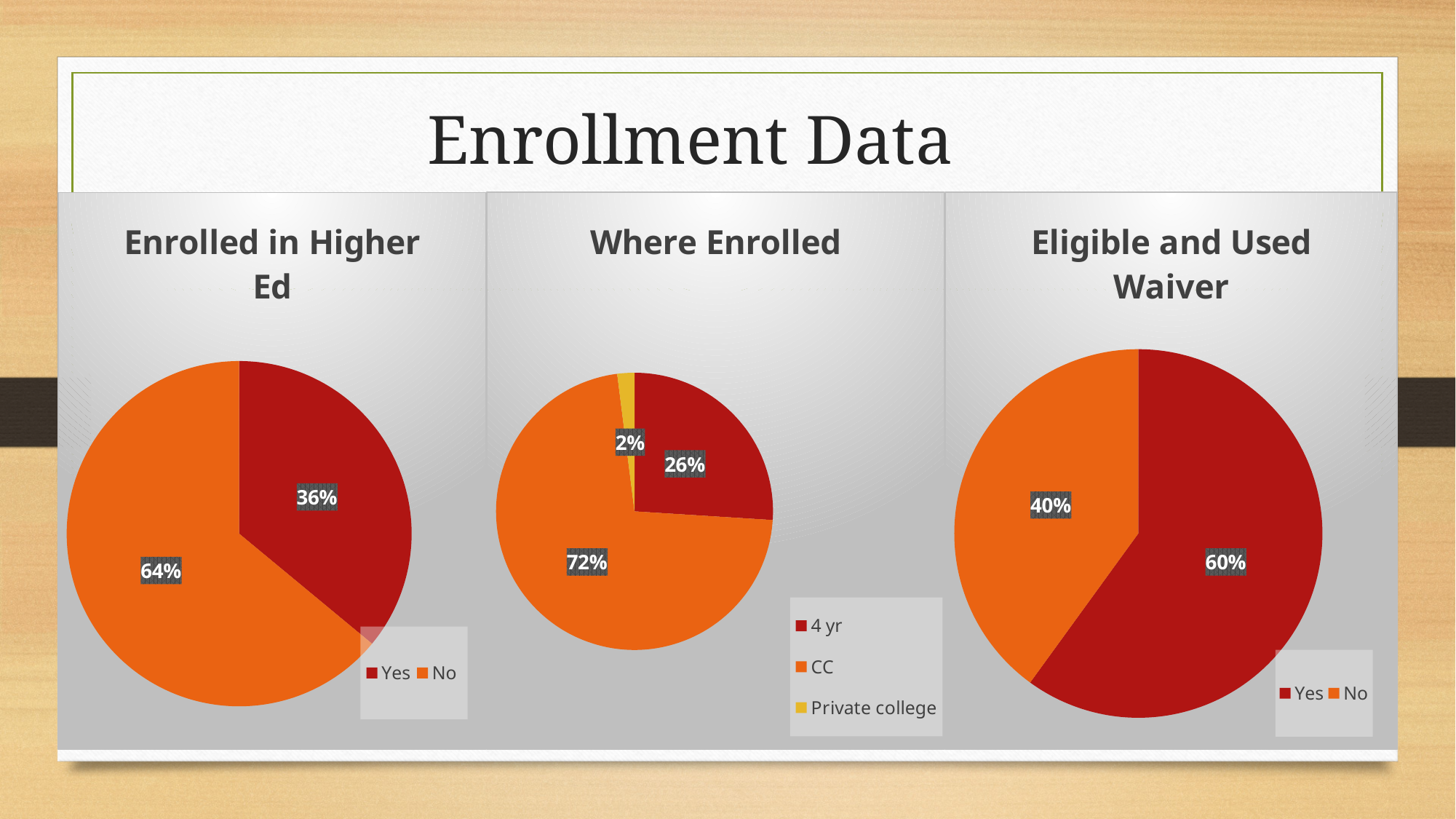
How many categories does the legend of the 'Where Enrolled' chart list? 3 In the 'Where Enrolled' chart, what percentage is labelled for Private college? 2% In the 'Where Enrolled' chart, what share is labelled for CC? 72% In the 'Where Enrolled' chart, what is the difference in percentage points between CC and 4 yr? 46 In the 'Enrolled in Higher Ed' chart, what is the difference in percentage points between No and Yes? 28 In the 'Enrolled in Higher Ed' chart, what percentage is labelled for Yes? 36% What type of chart is the 'Eligible and Used Waiver' chart? Pie chart In the 'Enrolled in Higher Ed' chart, what percentage is labelled for No? 64% In the 'Where Enrolled' chart, which category has the largest slice? CC In the 'Eligible and Used Waiver' chart, which is larger, Yes or No? Yes In the 'Eligible and Used Waiver' chart, what percentage is labelled for Yes? 60% In the 'Where Enrolled' chart, which category has the smallest slice? Private college